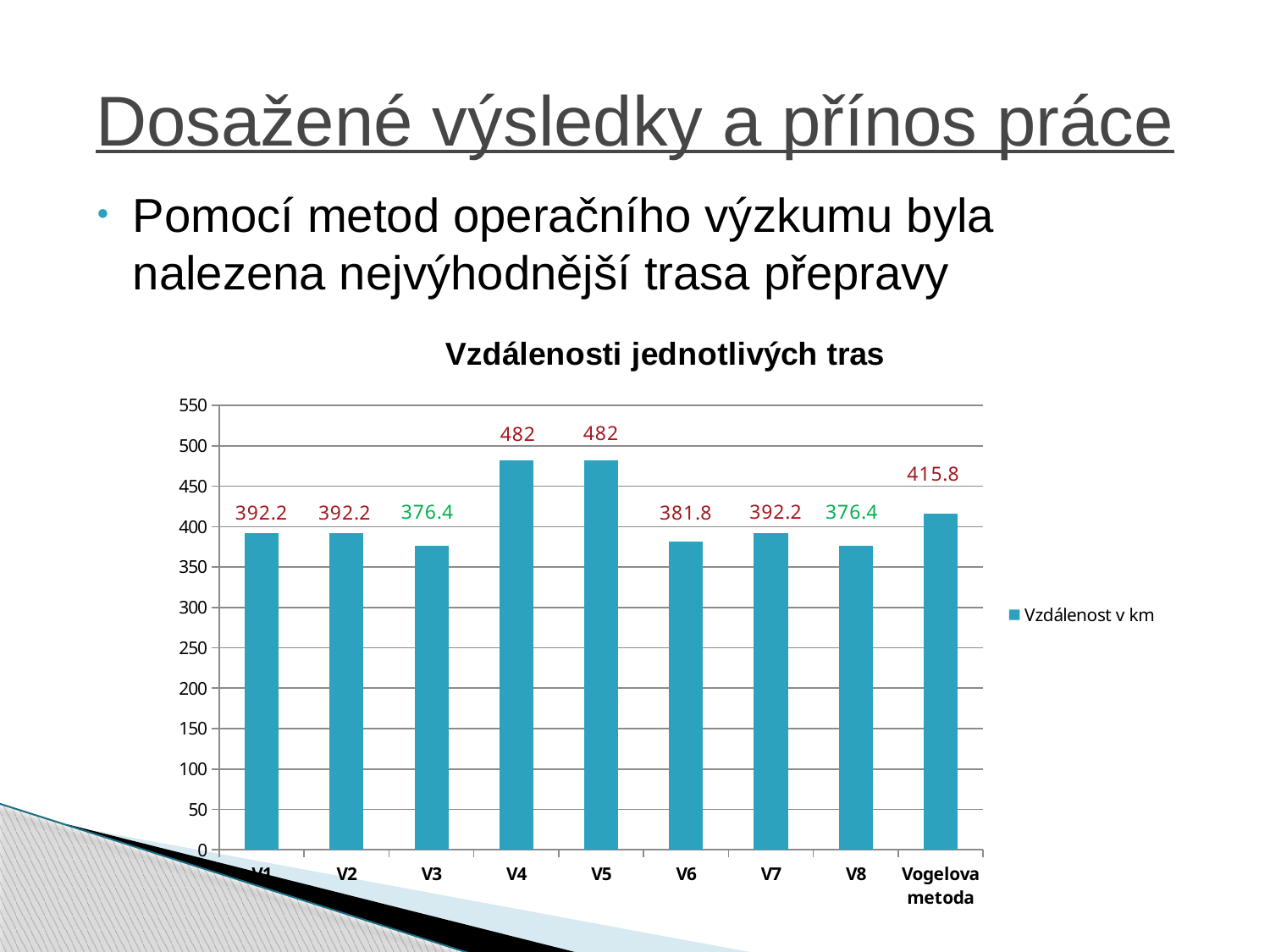
What is the highest value shown in the chart? 482 What is the value for V6 in the chart? 381.8 What kind of chart is shown on the slide? bar chart What is the difference between the values for V4 and V6? 100.2 What is the value for Vogelova metoda in the chart? 415.8 How many categories are shown on the x axis of the chart? 9 Which has a larger value, V5 or V7? V5 Is the value for V2 greater or less than 400? less What is the value for V3 in the chart? 376.4 What is the value for V4 in the chart? 482 What is the difference between the values for Vogelova metoda and V8? 39.4 What series name does the legend of the chart list? Vzdálenost v km